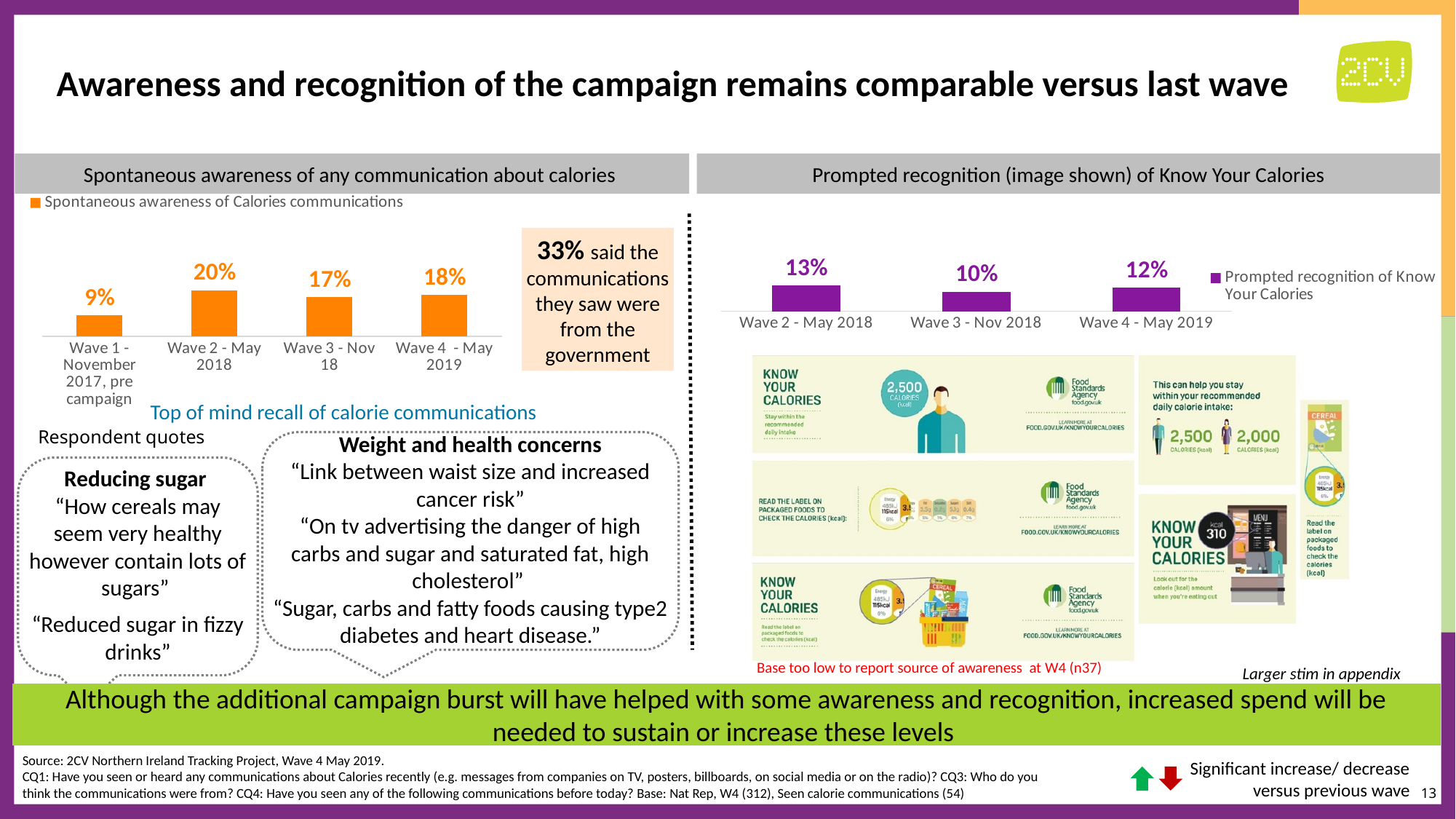
In the spontaneous awareness chart on the left, which wave has the lowest value? Wave 1 - November 2017, pre campaign In the prompted recognition chart on the right, how many waves are plotted? 3 In the spontaneous awareness chart on the left, what is the difference between Wave 2 - May 2018 and Wave 1 - November 2017? 11% In the spontaneous awareness chart on the left, what is the value for Wave 1 - November 2017, pre campaign? 9% In the prompted recognition chart on the right, what is the difference between Wave 4 - May 2019 and Wave 3 - Nov 2018? 2% In the spontaneous awareness chart on the left, how many waves are plotted? 4 In the prompted recognition chart on the right, which wave has the highest value? Wave 2 - May 2018 In the prompted recognition chart on the right, what is the value for Wave 2 - May 2018? 13% What type of chart is the spontaneous awareness chart on the left? Bar chart In the prompted recognition chart on the right, what is the value for Wave 3 - Nov 2018? 10% In the spontaneous awareness chart on the left, what is the value for Wave 4 - May 2019? 18% In the spontaneous awareness chart on the left, which wave has the highest value? Wave 2 - May 2018